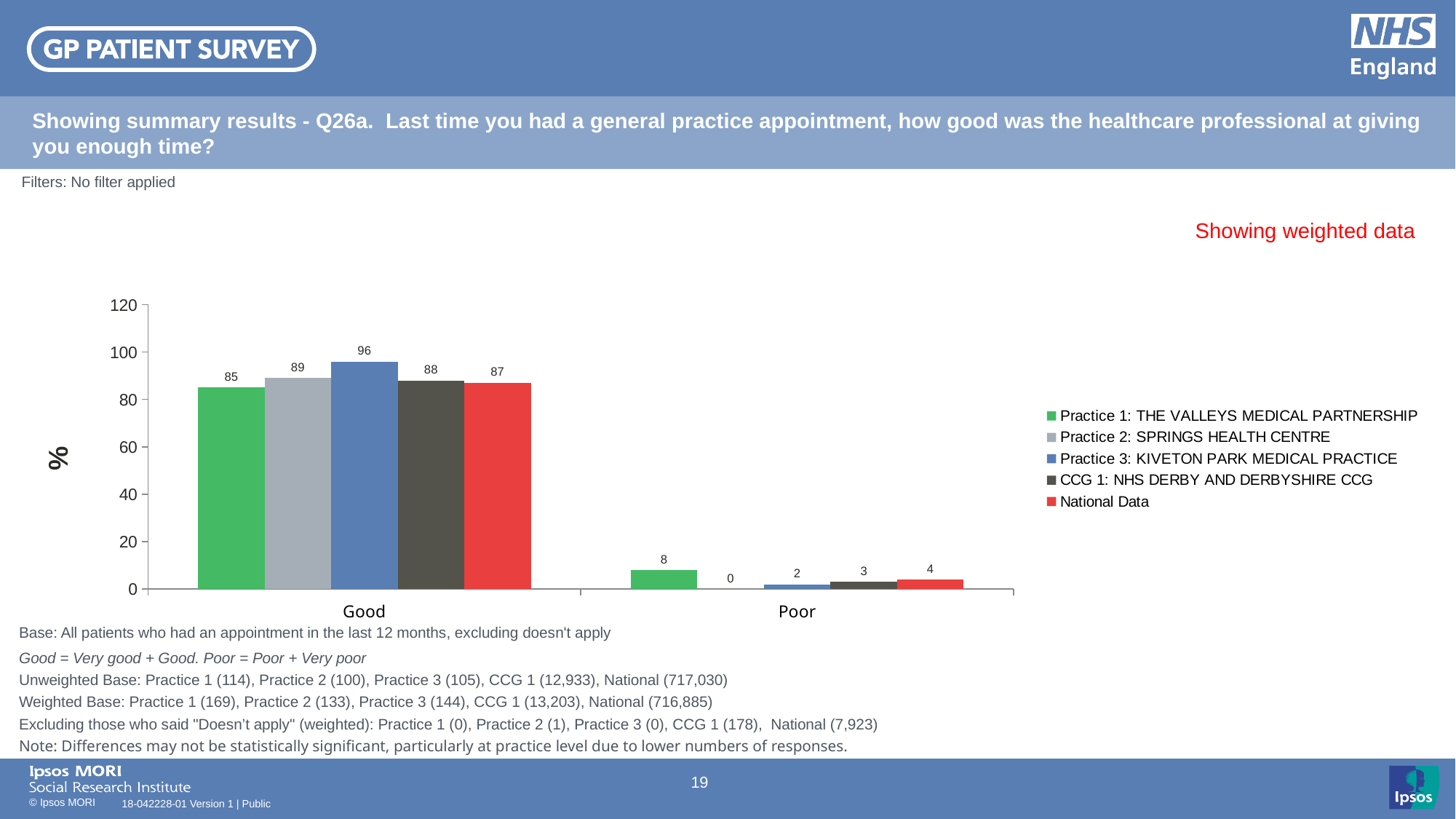
What colour represents National Data in the chart? red Which series has the lowest value in the Poor category? Practice 2: SPRINGS HEALTH CENTRE Is the value for National Data in the Good category greater or less than 80? greater How many series does the legend list? 5 How many categories are shown on the x axis? 2 What is the value for Practice 3: KIVETON PARK MEDICAL PRACTICE in the Good category? 96 What is the value for Practice 1: THE VALLEYS MEDICAL PARTNERSHIP in the Good category? 85 Which series has the highest value in the Good category? Practice 3: KIVETON PARK MEDICAL PRACTICE Which is larger in the Good category: Practice 2: SPRINGS HEALTH CENTRE or CCG 1: NHS DERBY AND DERBYSHIRE CCG? Practice 2: SPRINGS HEALTH CENTRE What is the value for National Data in the Poor category? 4 What kind of chart is shown on the slide? bar chart What is the difference between the Good values for Practice 3: KIVETON PARK MEDICAL PRACTICE and Practice 1: THE VALLEYS MEDICAL PARTNERSHIP? 11